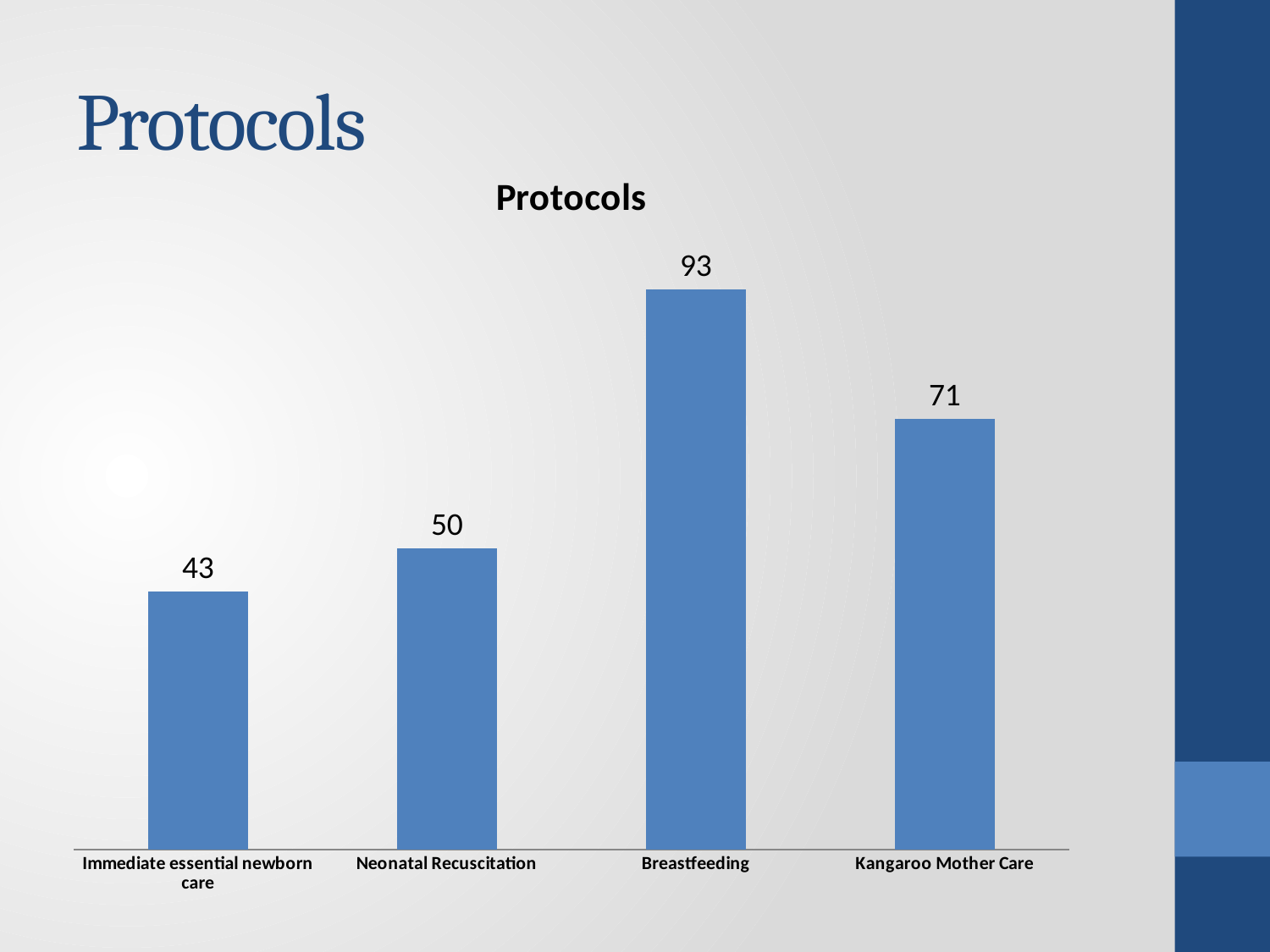
What is the value for Kangaroo Mother Care? 71 What is the difference between the values for Neonatal Recuscitation and Immediate essential newborn care? 7 Which category has the highest value? Breastfeeding How many categories are shown in the chart? 4 Which category has the lowest value? Immediate essential newborn care Which is larger, the value for Kangaroo Mother Care or the value for Neonatal Recuscitation? Kangaroo Mother Care What is the value for Breastfeeding? 93 What is the value for Immediate essential newborn care? 43 What is the value for Neonatal Recuscitation? 50 What kind of chart is shown on the slide? Bar chart What is the difference between the values for Breastfeeding and Kangaroo Mother Care? 22 What is the title of the chart? Protocols